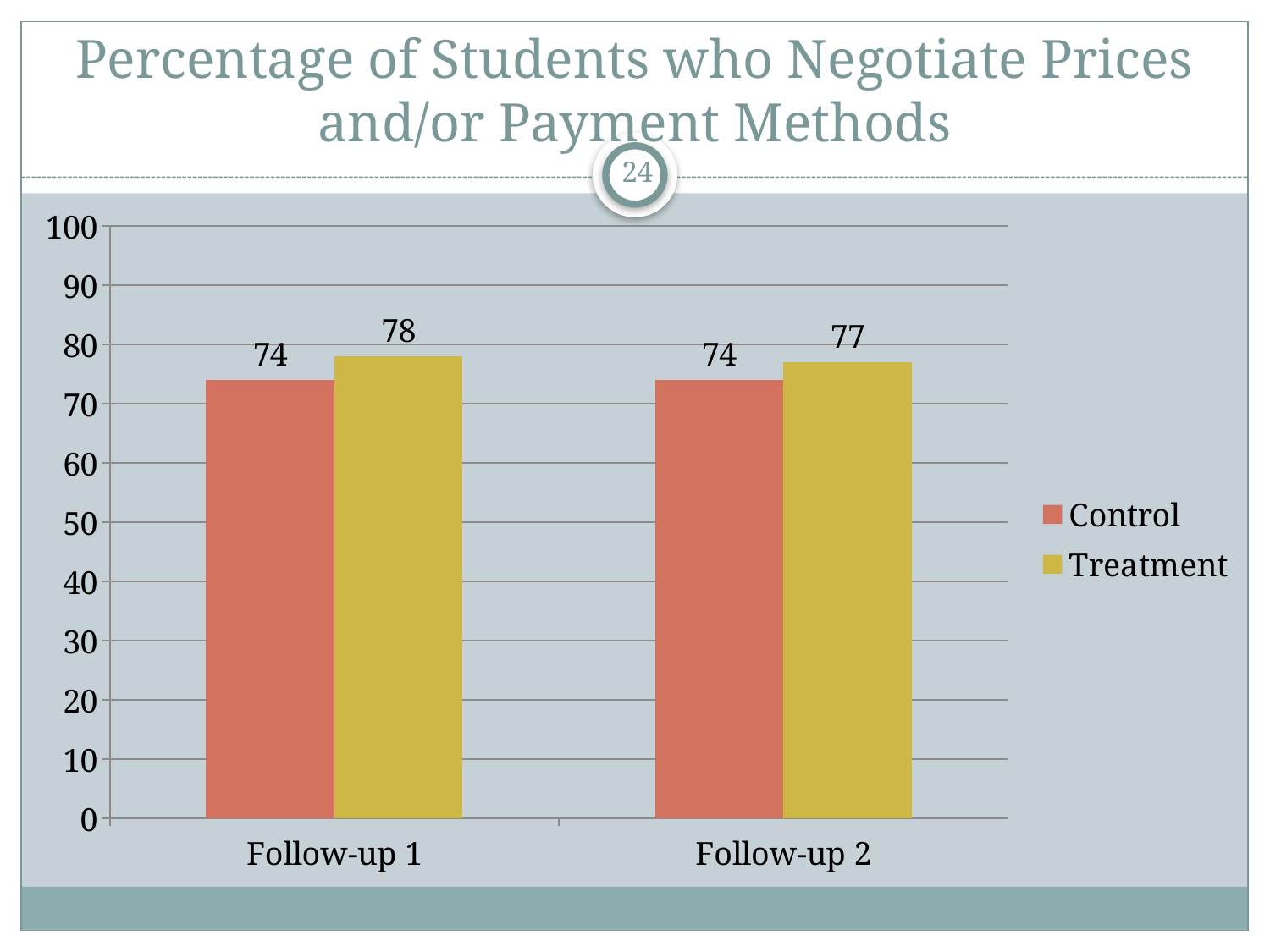
What kind of chart is shown on the slide? Bar chart What is the Treatment value for Follow-up 1? 78 What is the Control value for Follow-up 2? 74 How many categories are shown on the x axis? 2 What is the title of the chart? Percentage of Students who Negotiate Prices and/or Payment Methods How many series does the legend list? 2 Which is larger at Follow-up 2, Control or Treatment? Treatment Which series has the highest value at Follow-up 1? Treatment What is the Treatment value for Follow-up 2? 77 What is the difference between the Treatment and Control values at Follow-up 2? 3 What is the Control value for Follow-up 1? 74 What is the difference between the Treatment and Control values at Follow-up 1? 4